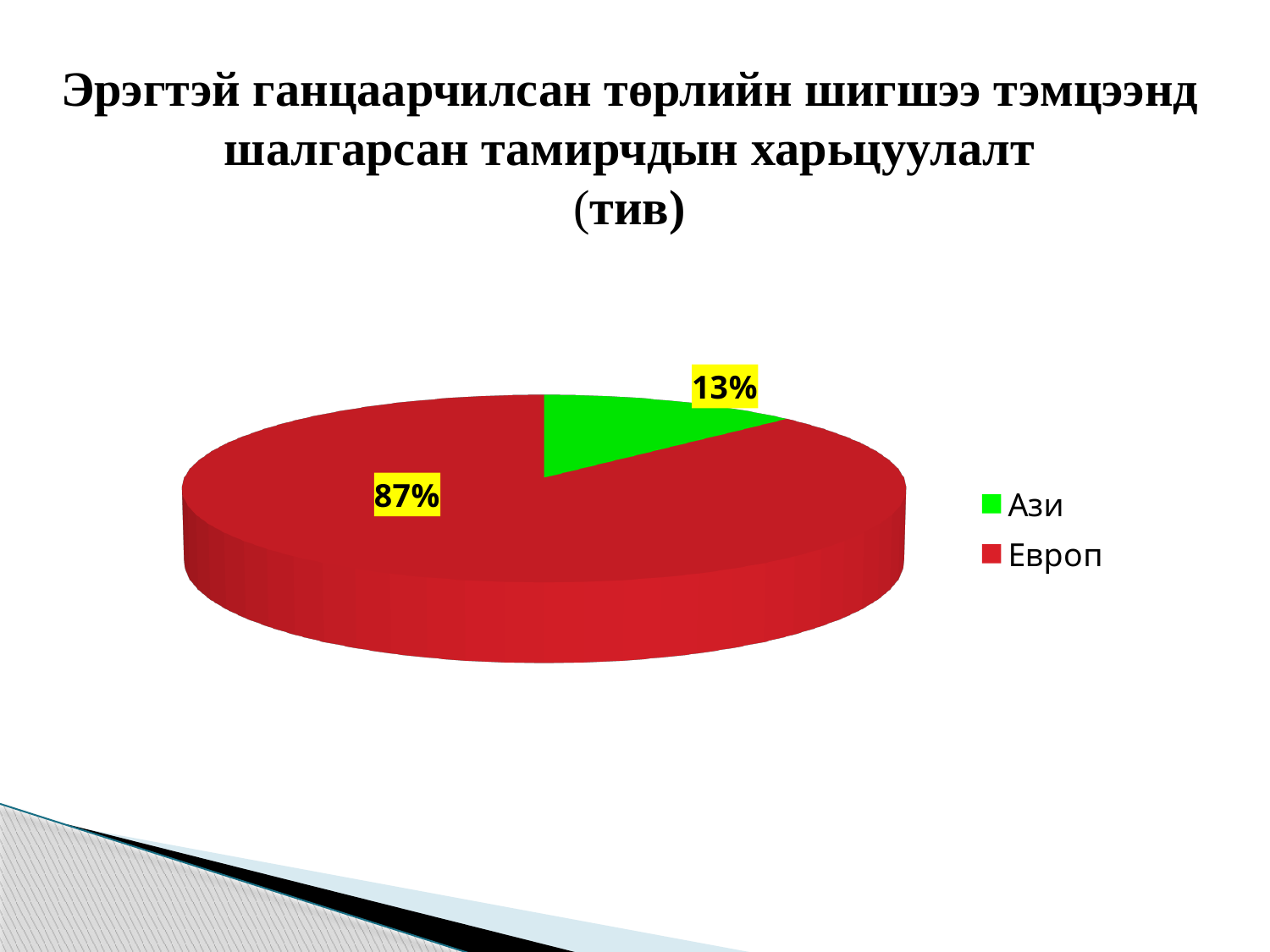
Which continent has the smallest slice of the pie? Ази What is the difference in percentage points between the Европ and Ази slices? 74 What share of the pie does Ази (Asia) represent? 13% What share of the pie does Европ (Europe) represent? 87% What colour is the Ази slice? green Which slice is larger, Ази or Европ? Европ How many entries does the legend list? 2 What kind of chart is shown on the slide? pie chart Which continent has the largest slice of the pie? Европ What colour is the Европ slice? red How many slices does the pie chart have? 2